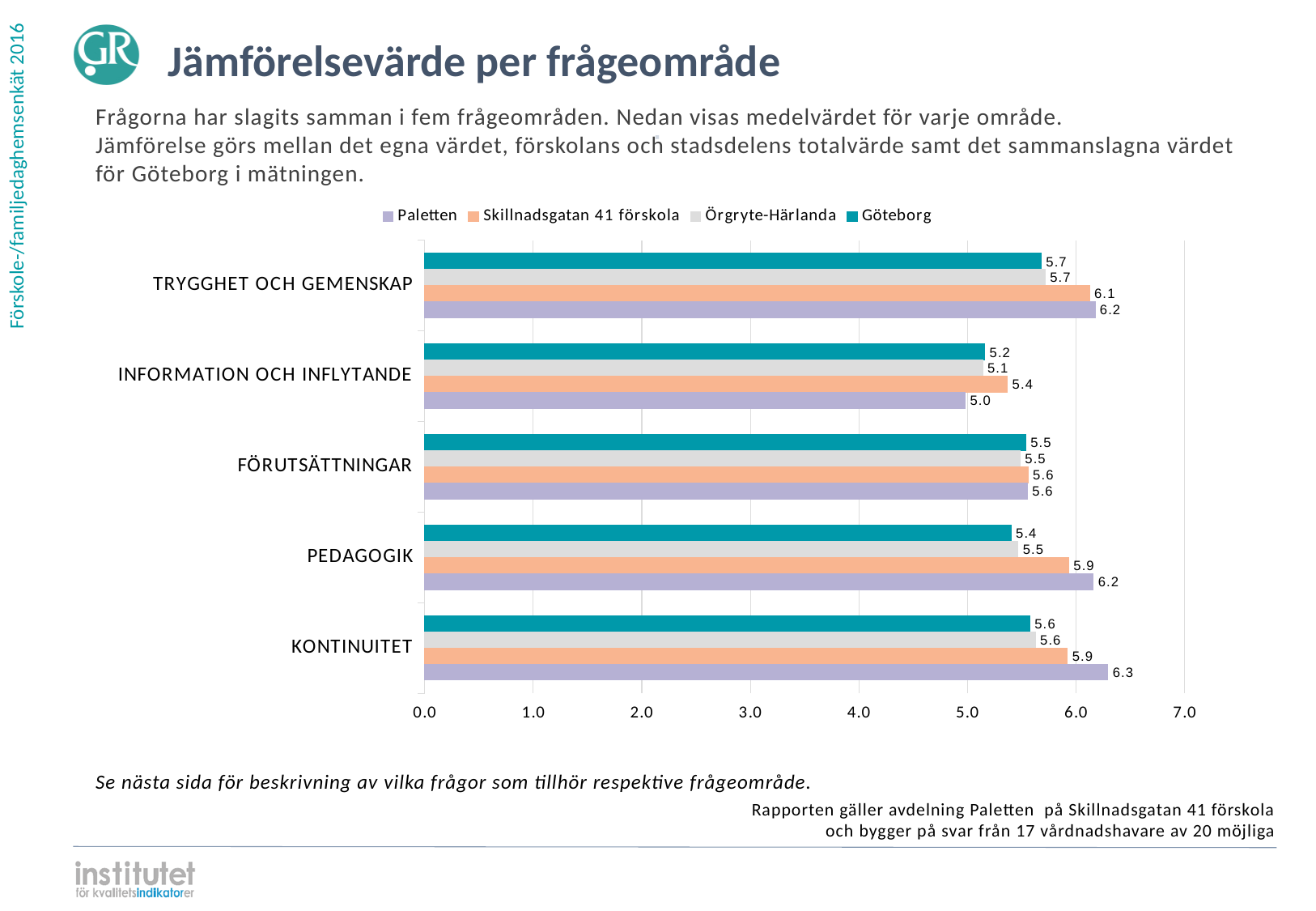
What is the value for Paletten in the KONTINUITET category? 6.3 What is the difference between the Paletten value and the Göteborg value in the PEDAGOGIK category? 0.8 What is the value for Skillnadsgatan 41 förskola in the PEDAGOGIK category? 5.9 In the INFORMATION OCH INFLYTANDE category, which is larger: the value for Skillnadsgatan 41 förskola or the value for Paletten? Skillnadsgatan 41 förskola What is the value for Göteborg in the INFORMATION OCH INFLYTANDE category? 5.2 Is the value for Paletten in the TRYGGHET OCH GEMENSKAP category greater or less than 6.0? greater What is the value for Örgryte-Härlanda in the TRYGGHET OCH GEMENSKAP category? 5.7 How many series does the legend list? 4 In which category does Paletten have its highest value? KONTINUITET What kind of chart is shown on the slide? Bar chart In which category does Paletten have its lowest value? INFORMATION OCH INFLYTANDE How many categories (frågeområden) are shown on the chart? 5